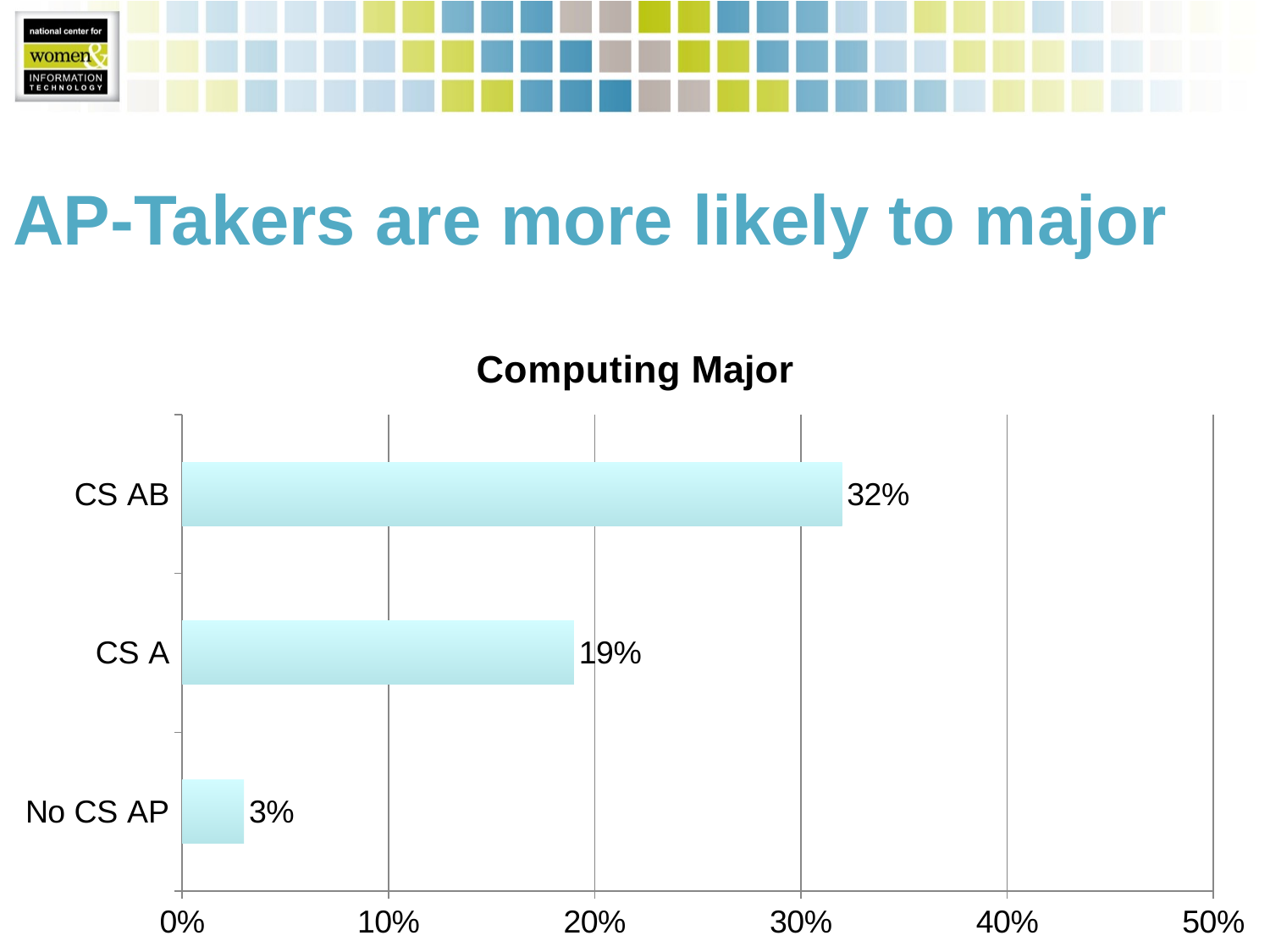
What is the value for CS AB? 32% How many categories are shown in the chart? 3 What is the difference between the values for CS AB and CS A? 13% Which category has the highest value? CS AB What kind of chart is shown on the slide? bar chart What is the title of the chart? Computing Major Which category has the lowest value? No CS AP Is the value for CS AB greater or less than 30%? greater What is the difference between the values for CS A and No CS AP? 16% What is the value for No CS AP? 3% Which is larger, the value for CS A or the value for No CS AP? CS A What is the value for CS A? 19%